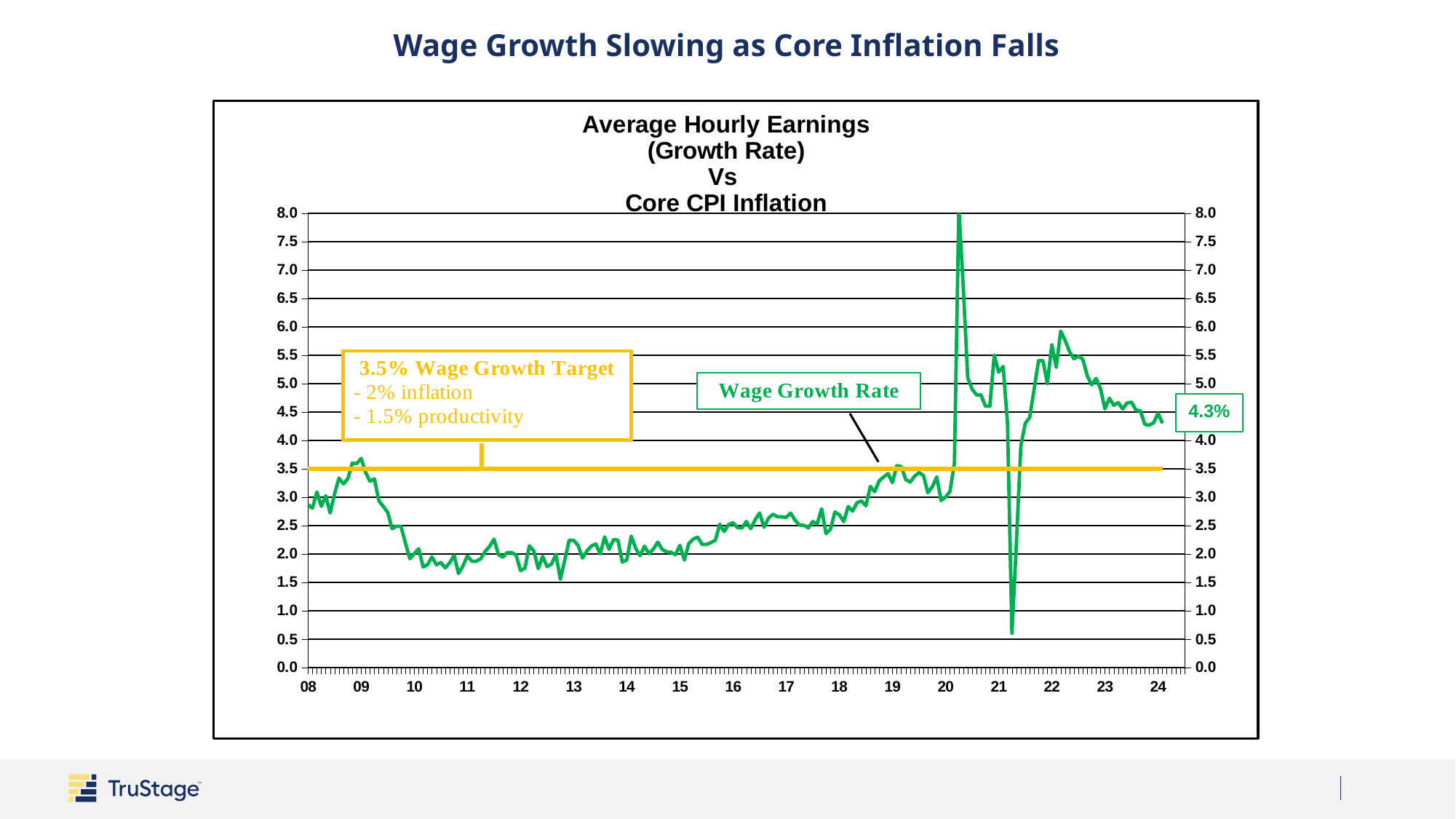
Is the lowest point of the Wage Growth Rate in 2021 greater or less than 1.0? less What kind of chart is shown on the slide? line chart Is the Wage Growth Rate in 2012 greater or less than 3.0? less What is the Wage Growth Target shown by the horizontal yellow line? 3.5% How many year labels are shown on the x axis? 17 Is the peak of the Wage Growth Rate in 2020 greater or less than 7.5? greater What two components make up the 3.5% Wage Growth Target according to the annotation box? 2% inflation and 1.5% productivity Does the Wage Growth Rate rise or fall from 2022 to 2024? fall Which year has a higher Wage Growth Rate, 2016 or 2022? 2022 What is the most recent value of the Wage Growth Rate labelled on the chart? 4.3% What is the title of the chart? Average Hourly Earnings (Growth Rate) Vs Core CPI Inflation